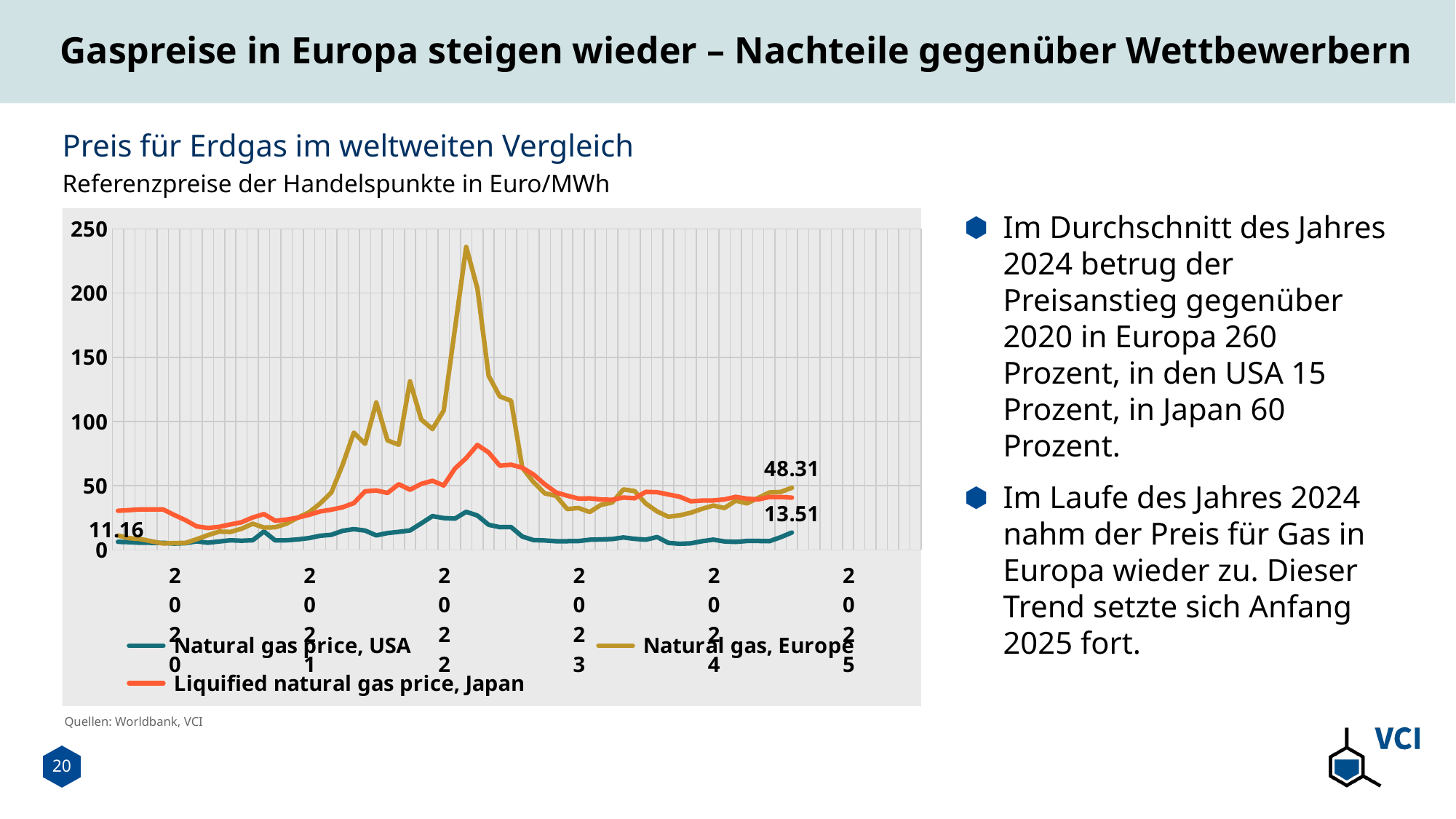
Does the Natural gas, Europe series rise or fall from its 2022 peak to 2023? fall What is the last labelled value for the Natural gas, Europe series? 48.31 What kind of chart is shown on the slide? line chart Which series stays lowest across the chart? Natural gas price, USA How many series does the chart legend list? 3 Is the peak value of the Natural gas, Europe series greater or less than 200? greater In what unit are the prices in the chart given, according to the subtitle? Euro/MWh At the end of the chart, which is larger: the Natural gas, Europe value or the Natural gas price, USA value? Natural gas, Europe What is the difference between the final labelled values for Natural gas, Europe (48.31) and Natural gas price, USA (13.51)? 34.80 What is the last labelled value for the Natural gas price, USA series? 13.51 Which series reaches the highest peak in the chart? Natural gas, Europe Is the peak value of the Liquified natural gas price, Japan series greater or less than 100? less